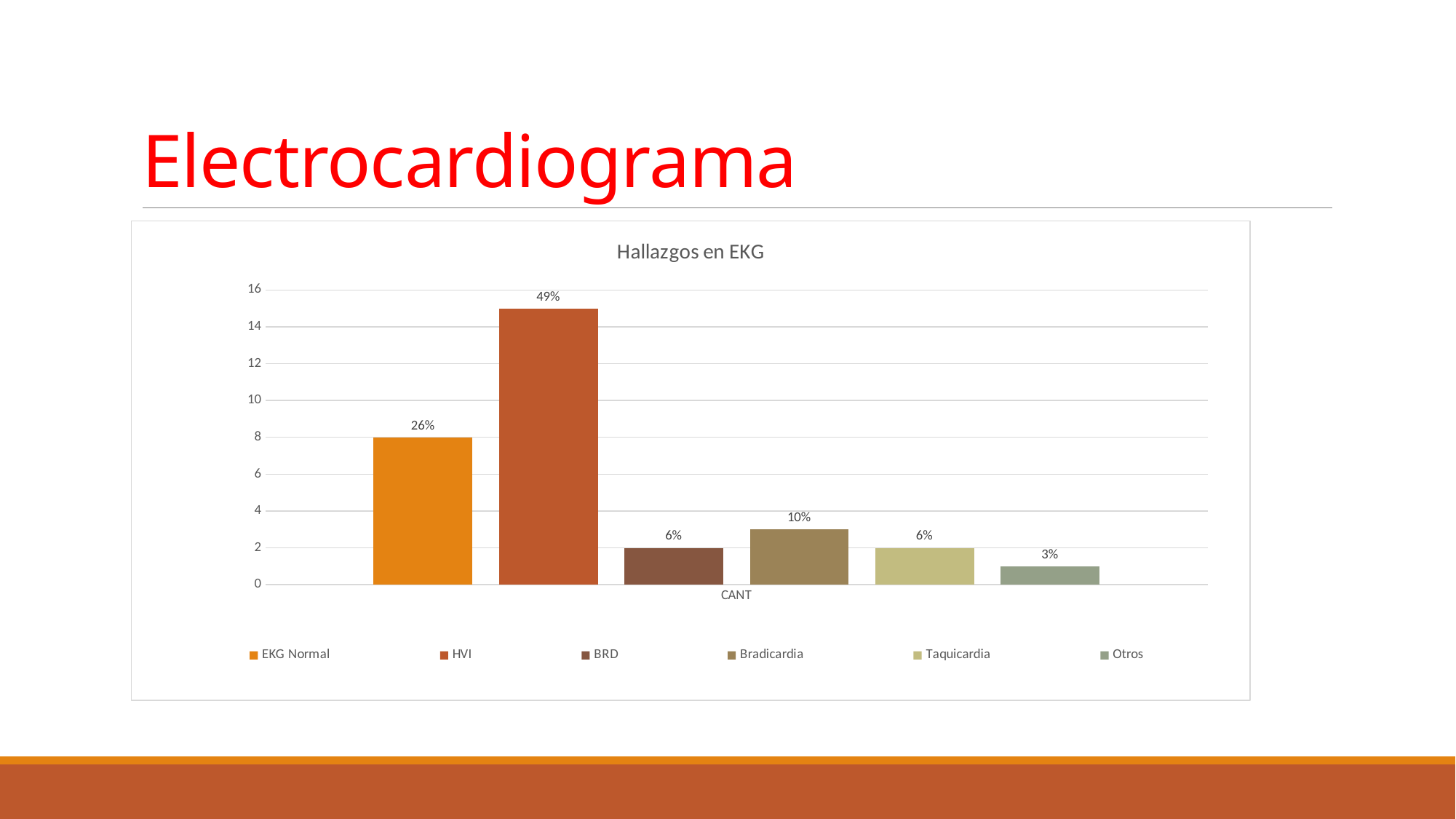
What data label is shown on the HVI bar? 49% What data label is shown on the EKG Normal bar? 26% What data label is shown on the Otros bar? 3% Which bar is taller, Bradicardia or Taquicardia? Bradicardia What is the difference between the percentage labels for HVI and EKG Normal? 23% What data label is shown on the Bradicardia bar? 10% Is the value for HVI greater or less than 14 on the vertical axis? greater How many series does the legend list? 6 Which series has the tallest bar in the chart? HVI What is the title of the chart? Hallazgos en EKG Which series has the shortest bar in the chart? Otros What kind of chart is shown on the slide? bar chart